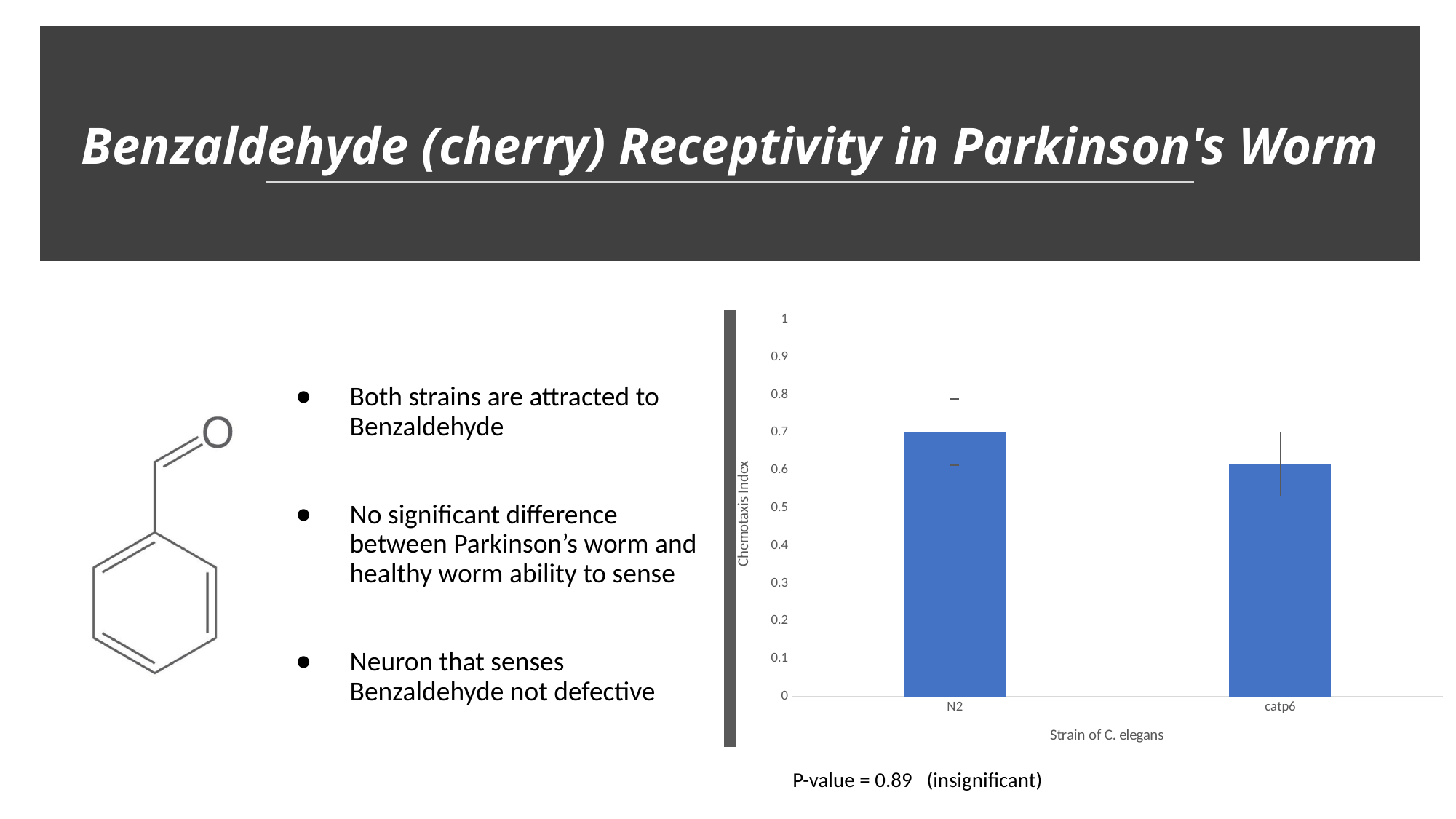
What is the label of the x axis of the chart? Strain of C. elegans Is the chemotaxis index for catp6 greater or less than 0.5? greater What kind of chart is shown on the slide? bar chart Which strain has the highest chemotaxis index? N2 What is the label of the y axis of the chart? Chemotaxis Index Is the chemotaxis index for catp6 greater or less than 0.7? less How many strains of C. elegans are plotted in the chart? 2 Is the chemotaxis index for N2 greater or less than 0.5? greater Which strain has a larger chemotaxis index, N2 or catp6? N2 Which strain has the lowest chemotaxis index? catp6